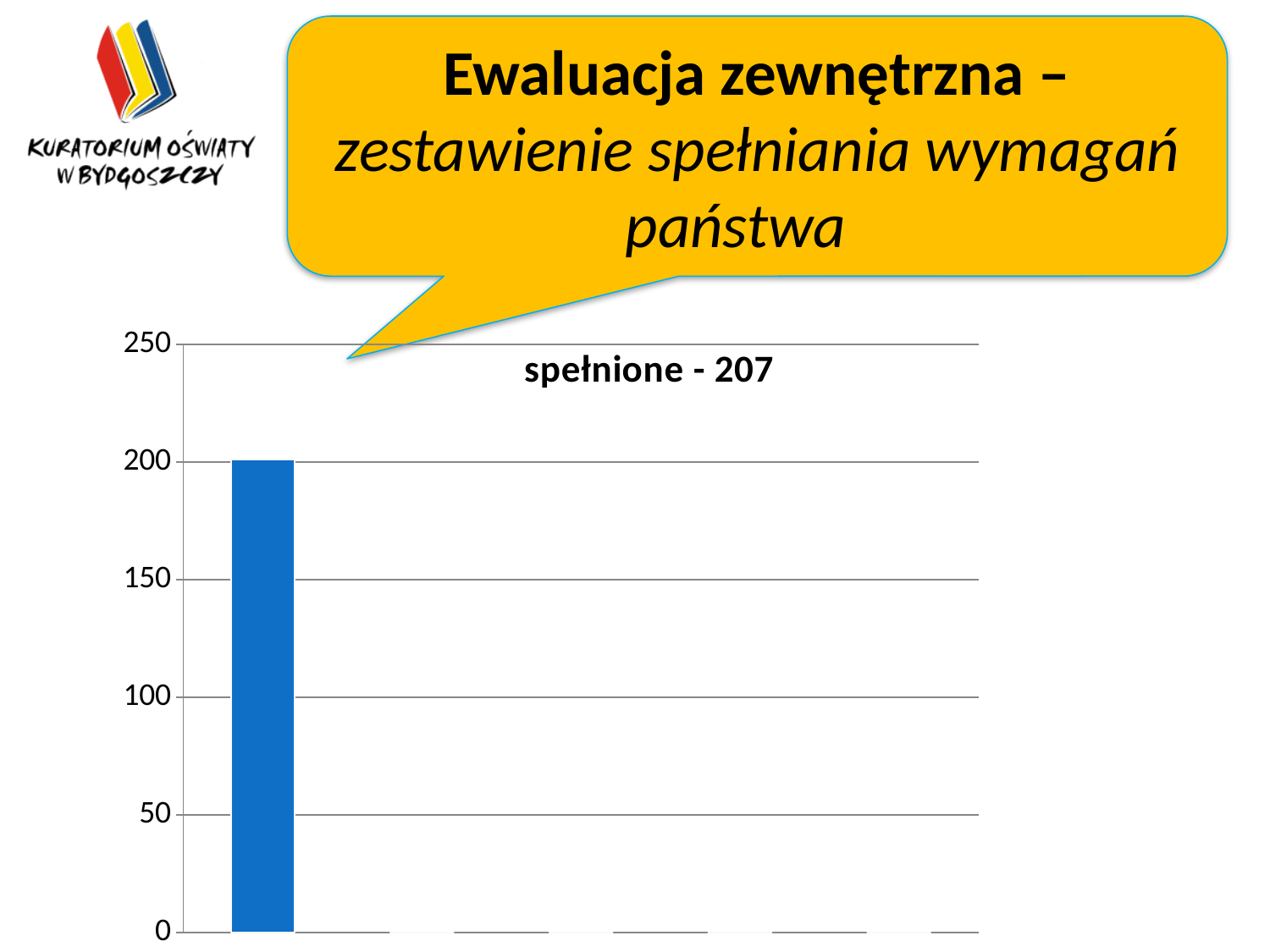
What is the highest value shown on the chart's vertical axis? 250 Is the value of the plotted bar greater or less than 250? less What kind of chart is shown on the slide? bar chart What is the lowest value shown on the chart's vertical axis? 0 Is the value of the plotted bar greater or less than 150? greater What number appears in the chart title after the word 'spełnione'? 207 How many bars are plotted in the chart? 1 Is the value of the plotted bar greater or less than 100? greater What is the title printed above the chart's plot area? spełnione - 207